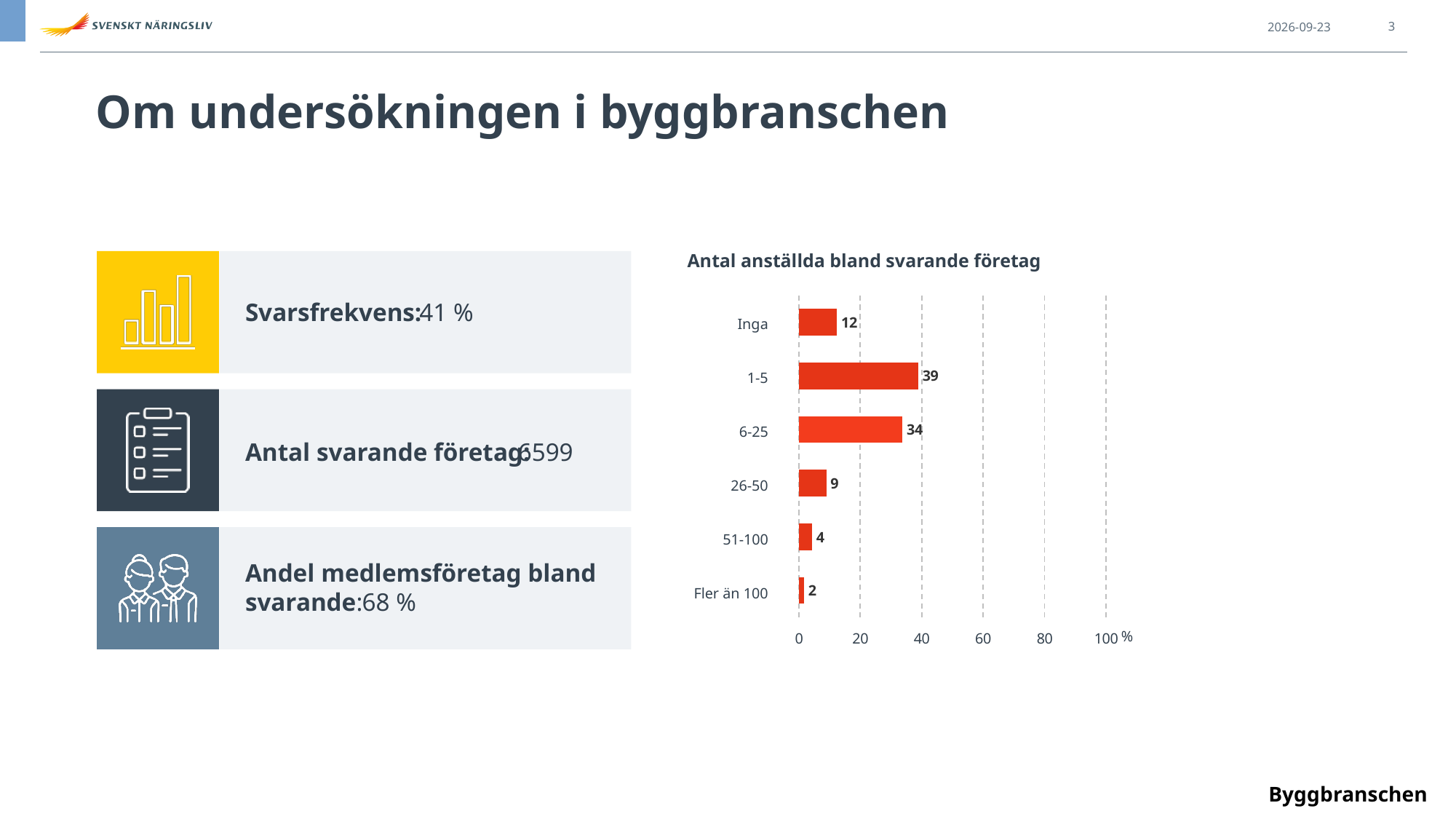
What is the difference between the values for 'Inga' and '26-50'? 3 What is the difference between the values for '1-5' and '6-25'? 5 What kind of chart is shown on the slide? bar chart What is the value for the '1-5' category in the chart 'Antal anställda bland svarande företag'? 39 Is the value for '6-25' greater or less than 20? greater What is the title of the chart on the slide? Antal anställda bland svarande företag Which category has the highest value in the chart? 1-5 How many categories are shown in the chart? 6 What is the value for 'Fler än 100' in the chart? 2 Which is larger, the value for '26-50' or the value for '51-100'? 26-50 Which category has the lowest value in the chart? Fler än 100 What is the value for 'Inga' in the chart? 12